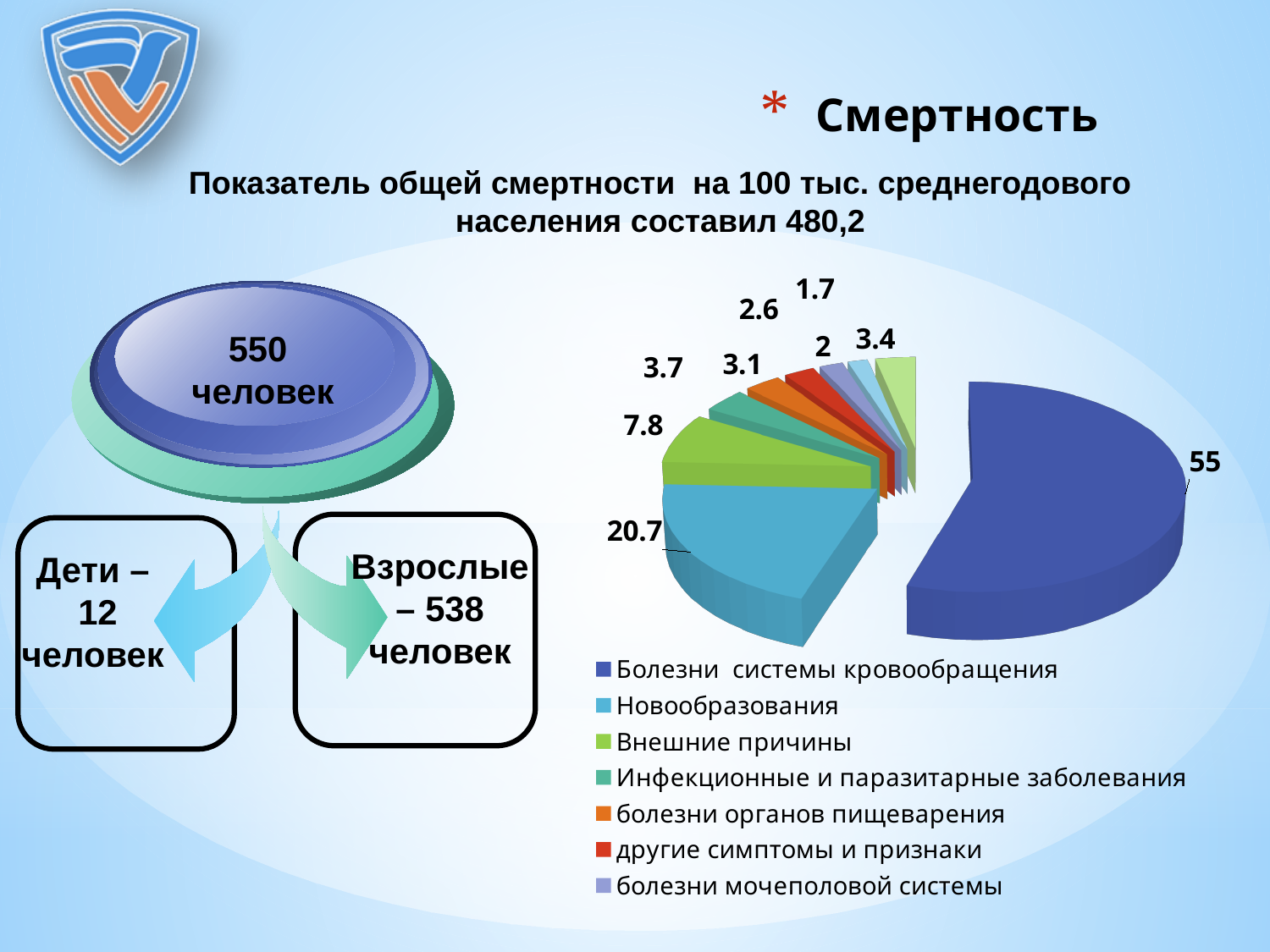
Which is larger in the pie chart: Внешние причины or Инфекционные и паразитарные заболевания? Внешние причины What is the value for Внешние причины in the pie chart? 7.8 What is the value for болезни органов пищеварения in the pie chart? 3.1 What is the value for Инфекционные и паразитарные заболевания in the pie chart? 3.7 What kind of chart is shown on the right side of the slide? pie chart What is the smallest value labelled on the pie chart? 1.7 How many entries does the legend of the pie chart list? 7 What is the value for Болезни системы кровообращения in the pie chart? 55 What is the value for Новообразования in the pie chart? 20.7 Which category has the largest slice in the pie chart? Болезни системы кровообращения How many slices does the pie chart have? 9 What is the difference between the values for Болезни системы кровообращения and Новообразования? 34.3